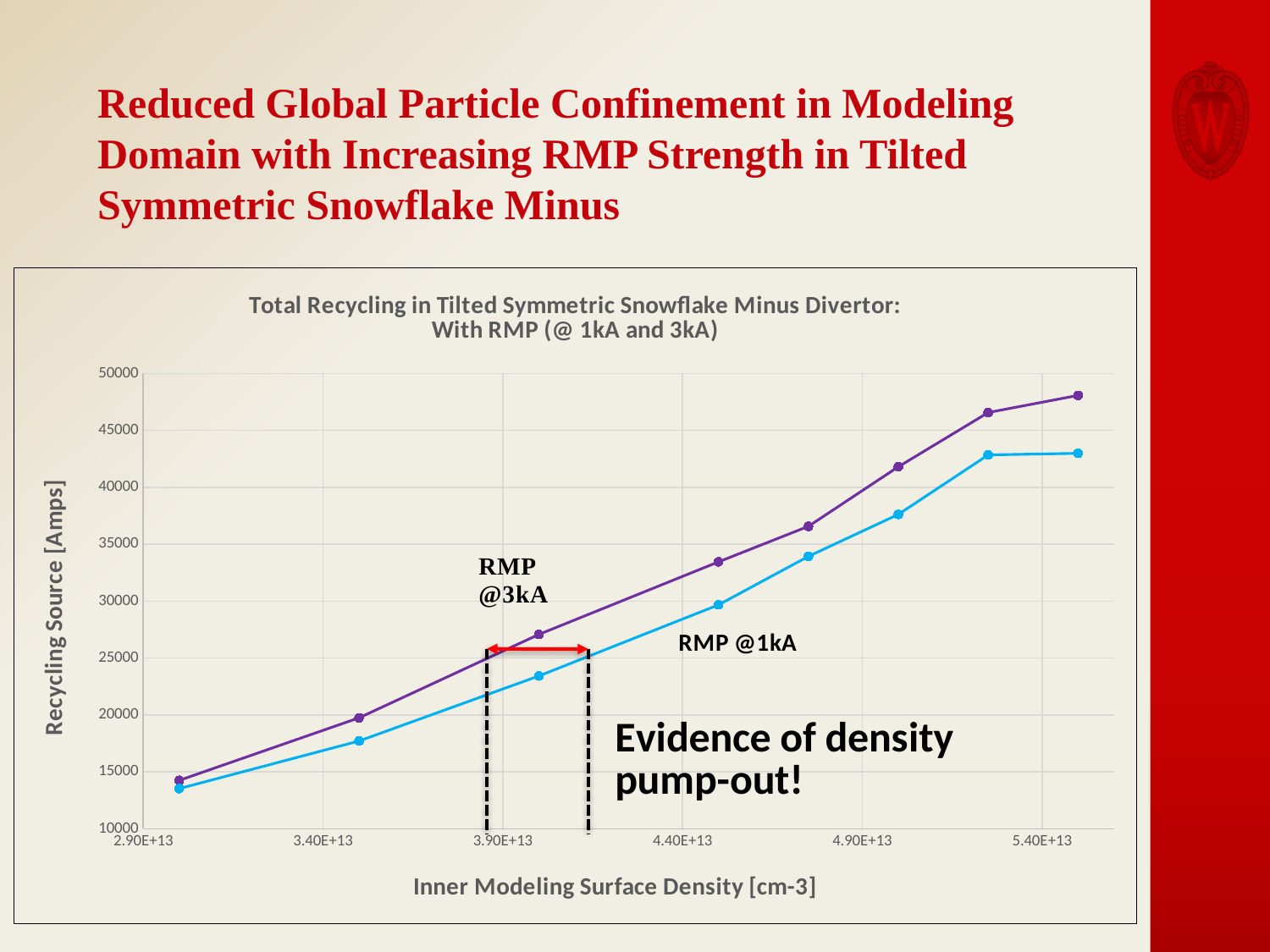
Is the highest value of the RMP @3kA series greater or less than 45000? greater Do the values of the RMP @1kA series rise or fall as the inner modeling surface density increases? rise What is the label of the y axis? Recycling Source [Amps] How many series are plotted on the chart? 2 How many data points does the RMP @3kA series have? 8 What is the title of the chart? Total Recycling in Tilted Symmetric Snowflake Minus Divertor: With RMP (@ 1kA and 3kA) Is the highest value of the RMP @1kA series greater or less than 45000? less Is the value of the RMP @3kA series at about 4.0E+13 cm-3 greater or less than 25000? greater Which series has the higher recycling source at the highest density shown, RMP @3kA or RMP @1kA? RMP @3kA Which series is plotted in purple? RMP @3kA What kind of chart is shown on the slide? line chart